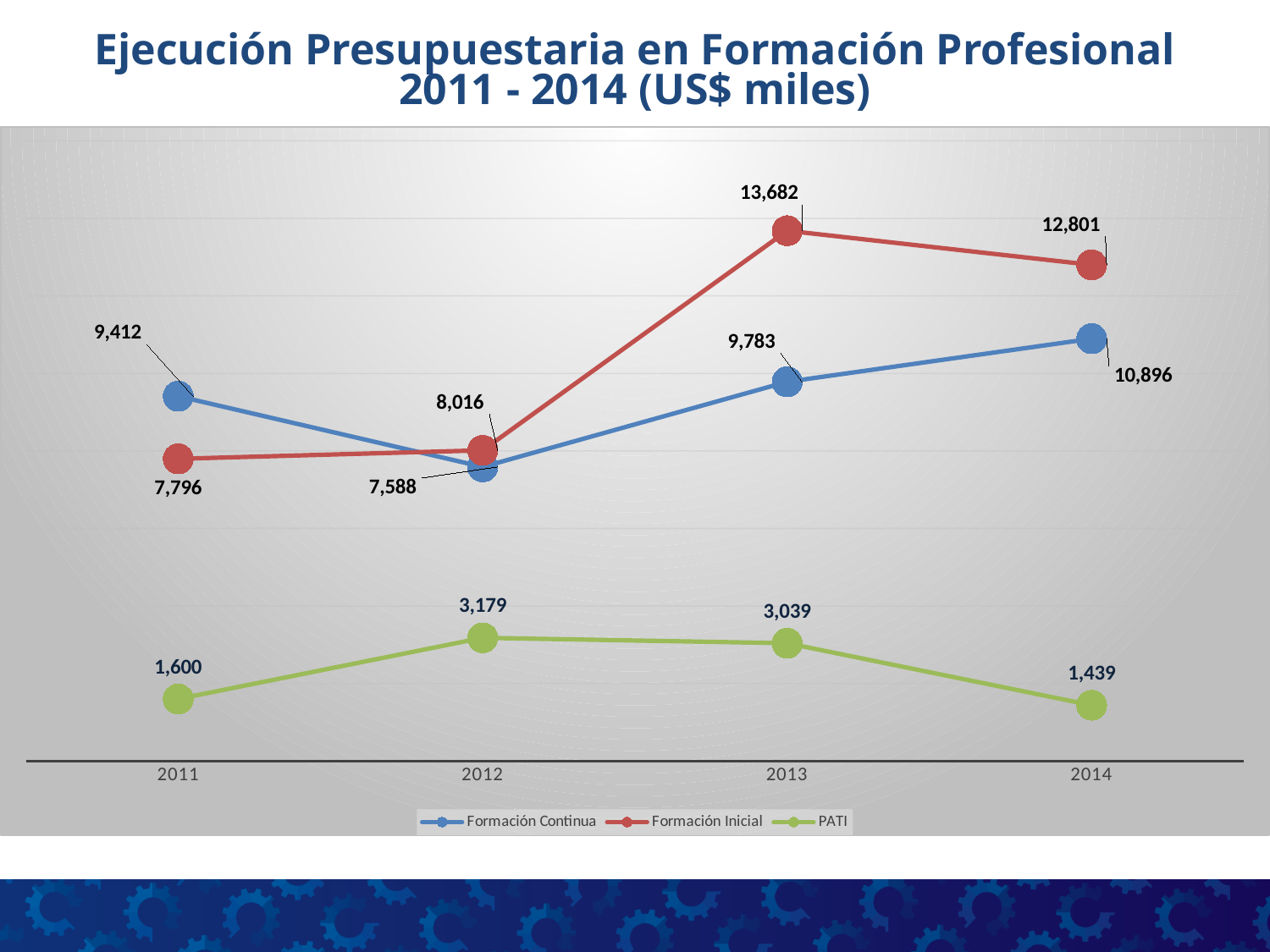
How many series does the legend list? 3 Does the PATI value rise or fall from 2013 to 2014? Fall In 2011, which is larger: Formación Continua or Formación Inicial? Formación Continua What kind of chart is shown on the slide? Line chart In which year is Formación Inicial highest? 2013 What is the value for PATI in 2012? 3,179 How many years are shown on the x axis? 4 What is the value for Formación Inicial in 2013? 13,682 In which year is Formación Continua lowest? 2012 By how much did PATI increase from 2011 to 2012? 1,579 What is the value for Formación Continua in 2014? 10,896 What is the difference between Formación Inicial and Formación Continua in 2013? 3,899